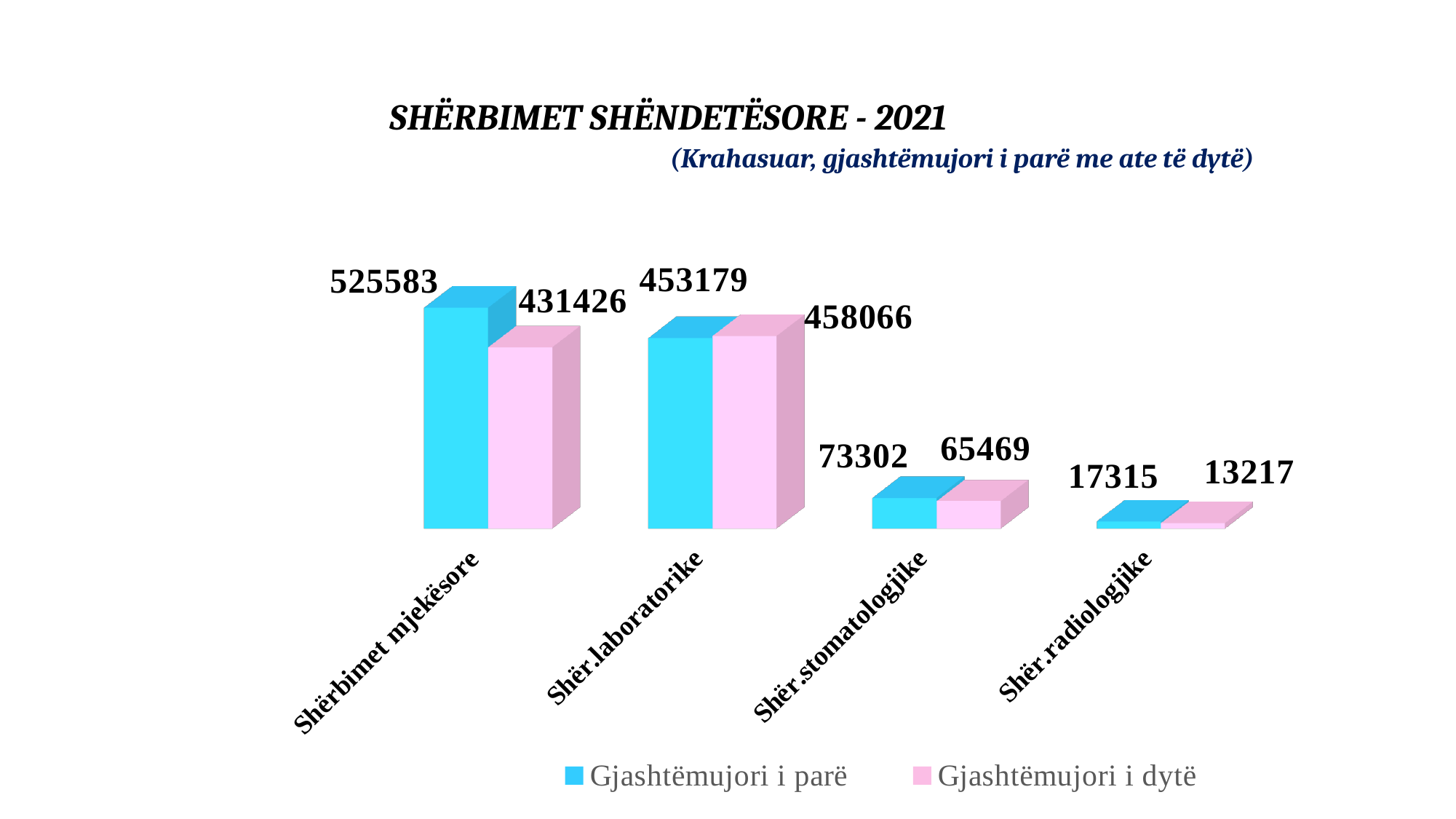
What is the value for Shërbimet mjekësore in the Gjashtëmujori i parë series? 525583 How many series does the legend list? 2 What is the difference between the Gjashtëmujori i parë and Gjashtëmujori i dytë values for Shërbimet mjekësore? 94157 What is the value for Shër.laboratorike in the Gjashtëmujori i dytë series? 458066 What is the difference between the Gjashtëmujori i dytë and Gjashtëmujori i parë values for Shër.laboratorike? 4887 What is the value for Shër.radiologjike in the Gjashtëmujori i dytë series? 13217 How many categories are shown on the x axis? 4 Which category has the highest value in the Gjashtëmujori i parë series? Shërbimet mjekësore Which category has the lowest value in the Gjashtëmujori i dytë series? Shër.radiologjike What kind of chart is shown on the slide? Bar chart What is the value for Shër.stomatologjike in the Gjashtëmujori i parë series? 73302 For Shër.stomatologjike, which series has the larger value: Gjashtëmujori i parë or Gjashtëmujori i dytë? Gjashtëmujori i parë